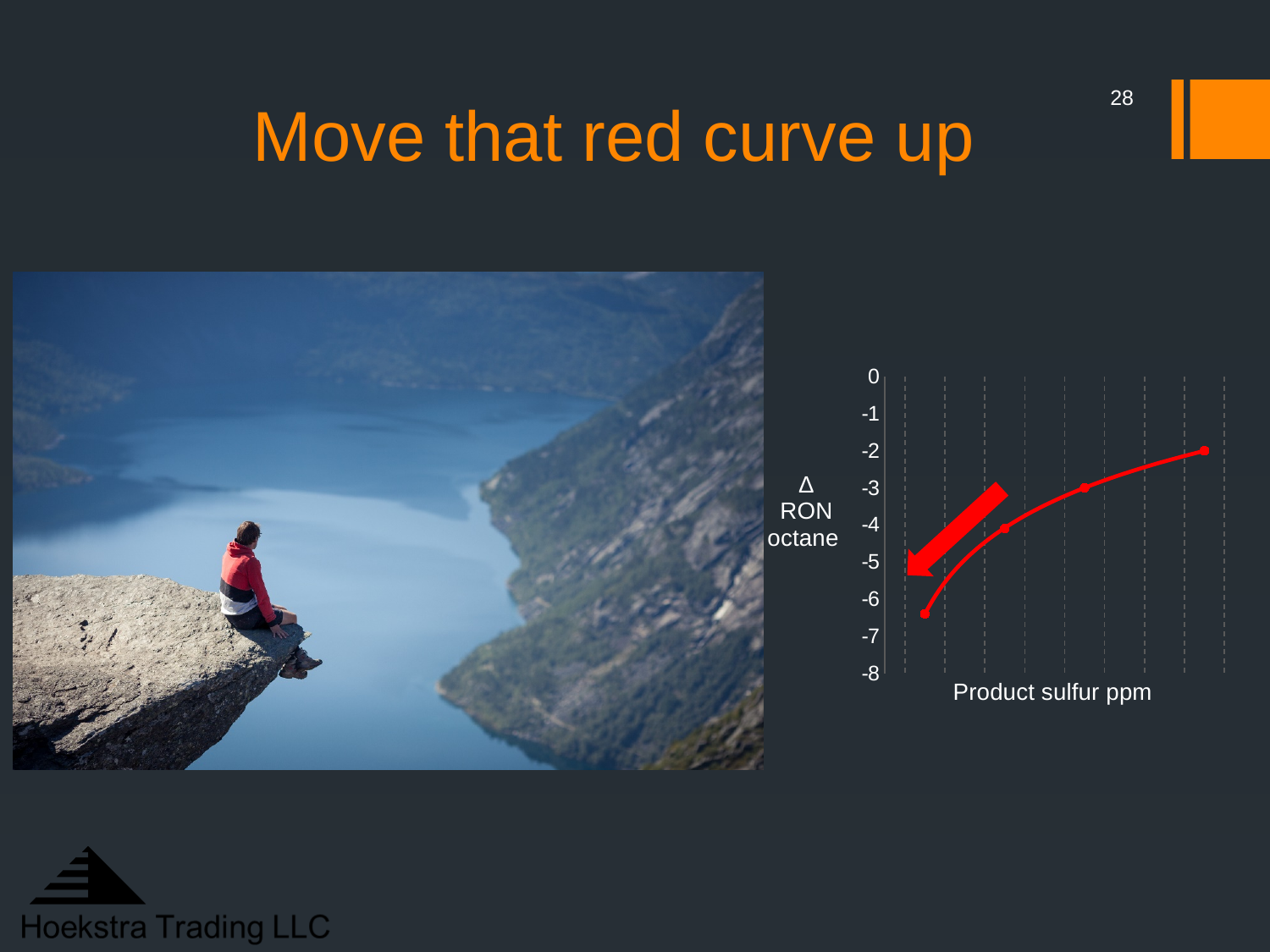
What kind of chart is shown on the slide? line chart How many data points are marked on the red curve? 4 Which point on the red curve has the lowest Δ RON octane value, the leftmost or the rightmost? leftmost Is the value of the leftmost point on the red curve greater or less than -5? less What is the label of the y axis of the chart? Δ RON octane Which point on the red curve has the highest Δ RON octane value, the leftmost or the rightmost? rightmost Is the value of the leftmost point on the red curve greater or less than -6? less Do the values on the red curve rise or fall as product sulfur ppm increases along the x axis? rise What is the label of the x axis of the chart? Product sulfur ppm Is the value of the rightmost point on the red curve greater or less than -3? greater Which is larger, the value of the leftmost point or the value of the rightmost point on the red curve? rightmost point